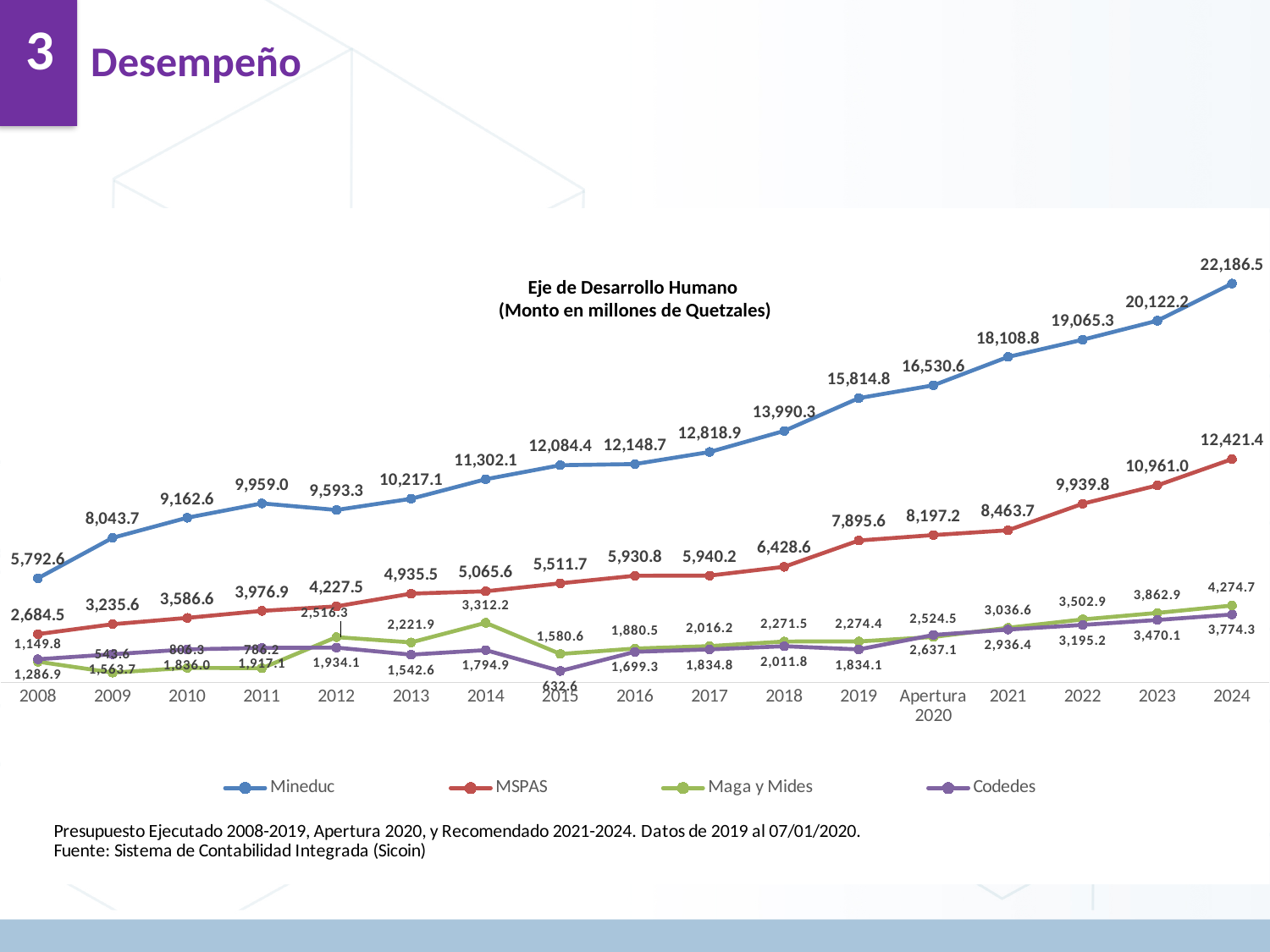
What is the value for MSPAS in 2019? 7,895.6 What is the value for Mineduc in 2008? 5,792.6 How many series does the legend list? 4 Does the Mineduc series generally rise or fall from 2008 to 2024? rise Which is larger, the MSPAS value in 2012 or in 2013? 2013 What type of chart is shown on the slide? line chart Which series has the highest value in 2024? Mineduc How many points are plotted along the x axis for each series? 17 What is the difference between the Mineduc values for 2024 and 2023? 2,064.3 What is the value for Maga y Mides in 2024? 4,274.7 What is the value for Codedes in 2015? 632.6 What is the value for Mineduc in 2024? 22,186.5